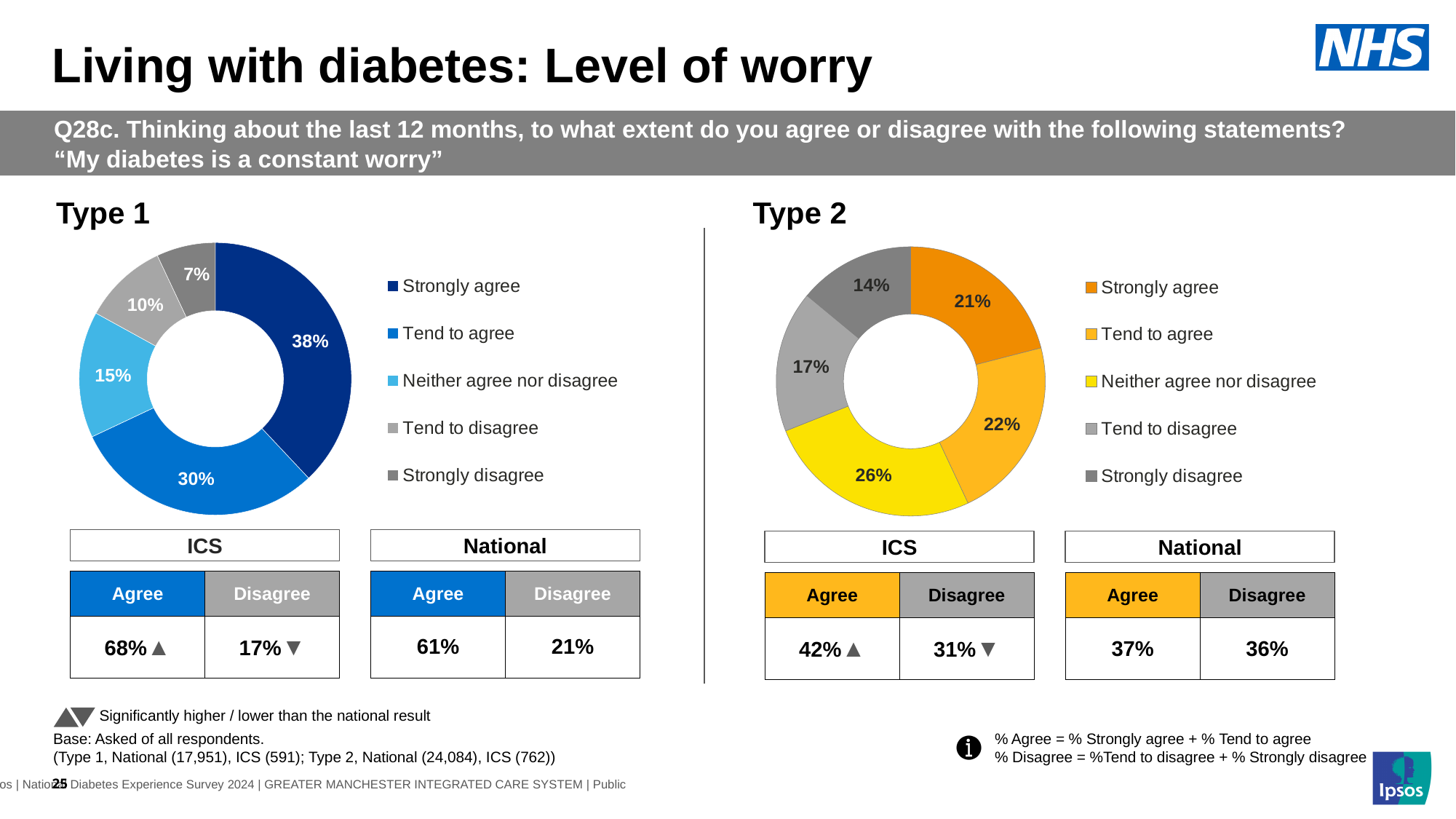
In the Type 1 chart, which response category has the largest share? Strongly agree How many slices does the Type 1 chart have? 5 In the Type 2 chart, which response category has the smallest share? Strongly disagree In the Type 2 chart, what colour is the Strongly agree slice? Orange In the Type 2 chart, what is the combined share of Tend to disagree and Strongly disagree? 31% In the Type 2 chart, which is larger: Tend to agree or Tend to disagree? Tend to agree What kind of chart is used for Type 1? Doughnut (pie) chart How many entries does the legend of the Type 2 chart list? 5 In the Type 1 chart, what is the combined share of Strongly agree and Tend to agree? 68% In the Type 1 chart, what percentage of respondents strongly agree? 38% In the Type 2 chart, what percentage of respondents neither agree nor disagree? 26% In the Type 1 chart, what is the difference between the Tend to agree and Tend to disagree shares? 20%